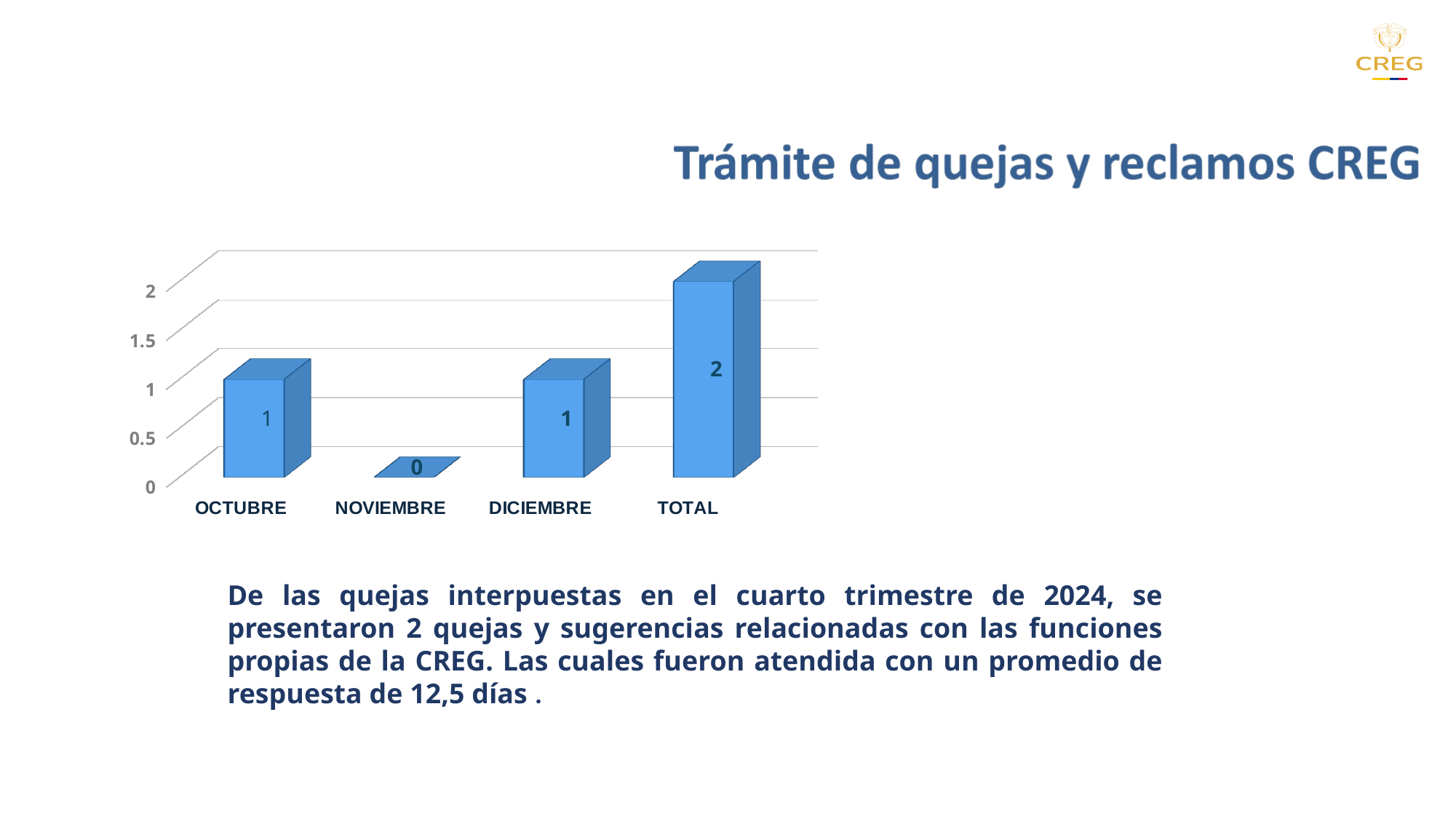
What is the title of the slide containing the chart? Trámite de quejas y reclamos CREG What is the value for NOVIEMBRE? 0 Which is larger, the value for DICIEMBRE or the value for NOVIEMBRE? DICIEMBRE What is the value for DICIEMBRE? 1 What is the value for OCTUBRE? 1 What is the value for TOTAL? 2 Is the value for TOTAL greater or less than 1.5? greater Which category has the lowest value? NOVIEMBRE What is the difference between the values for TOTAL and OCTUBRE? 1 What kind of chart is shown on the slide? bar chart How many categories are shown on the x axis? 4 Which category has the highest value? TOTAL